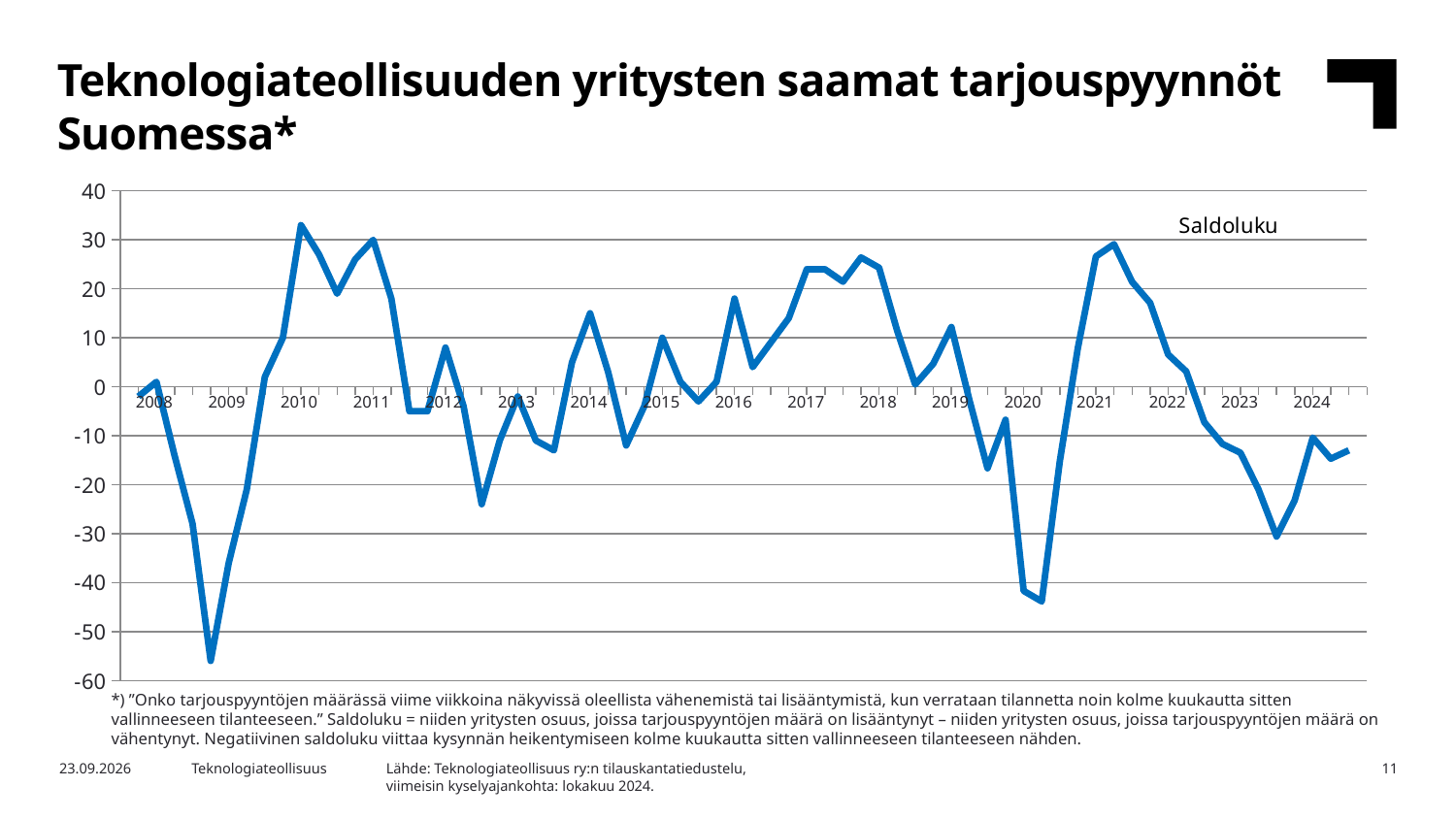
Is the lowest value of the line in 2023 greater or less than -20? less Is the lowest value of the line in 2009 greater or less than -50? less What is the title of the chart on the slide? Saldoluku What is the name of the series shown in the chart? Saldoluku Is the peak value of the line in 2010 greater or less than 30? greater Does the line rise or fall from its 2021 peak to 2023? fall In which year does the line reach its lowest point? 2009 What kind of chart is shown on the slide? line chart How many year labels are shown on the x axis? 17